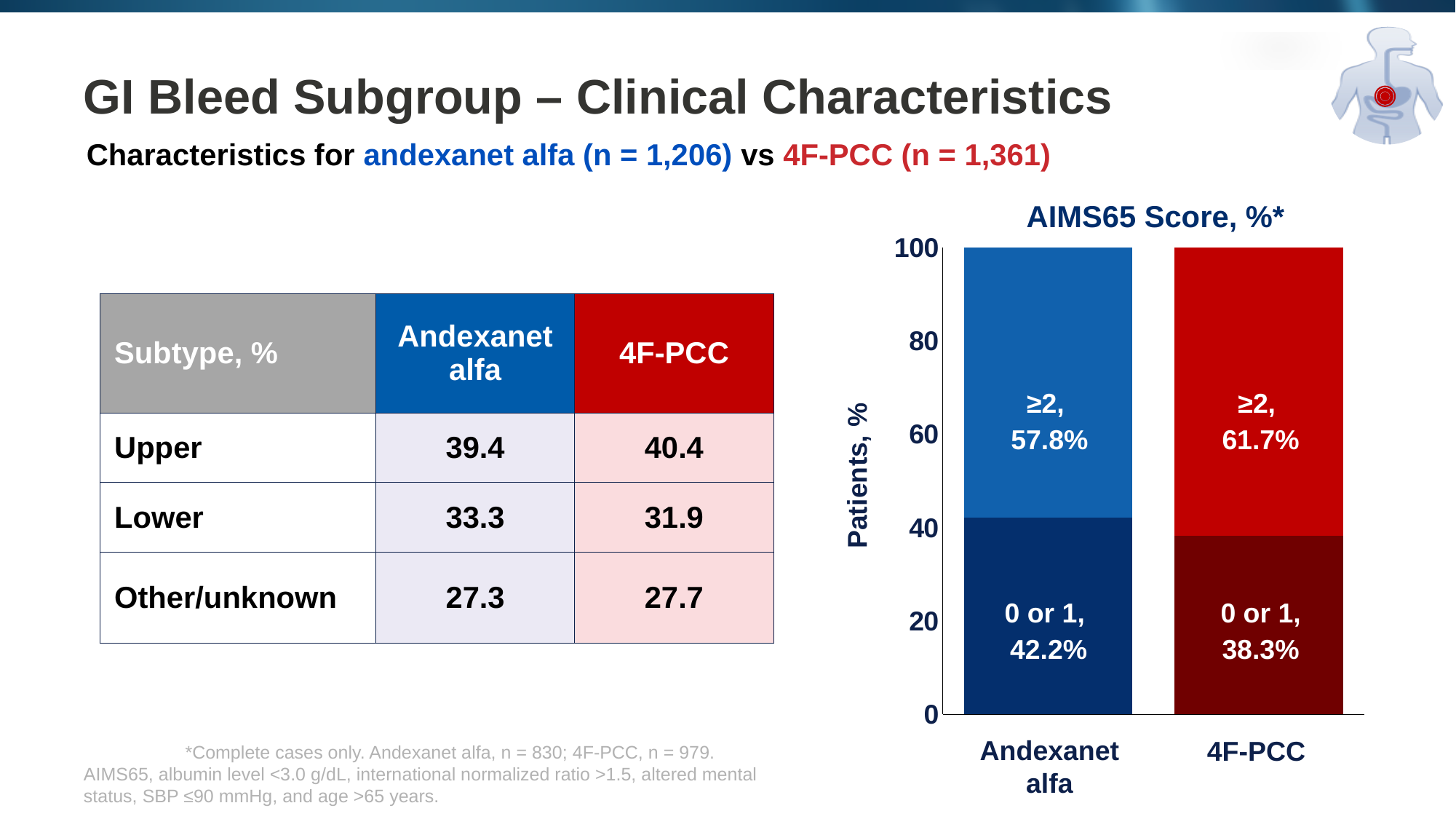
How many bars are shown in the AIMS65 Score chart? 2 In the AIMS65 Score chart, which group has the larger share of patients with a score of 0 or 1? Andexanet alfa What is the y-axis label of the AIMS65 Score chart? Patients, % In the AIMS65 Score chart, is the 0 or 1 share for 4F-PCC greater or less than 40? less In the AIMS65 Score chart, what percentage of andexanet alfa patients had a score of ≥2? 57.8% In the AIMS65 Score chart, what percentage of andexanet alfa patients had a score of 0 or 1? 42.2% What type of chart is the AIMS65 Score chart? Stacked bar chart In the AIMS65 Score chart, which group has the larger share of patients with a score of ≥2, andexanet alfa or 4F-PCC? 4F-PCC In the AIMS65 Score chart, what percentage of 4F-PCC patients had a score of 0 or 1? 38.3% In the AIMS65 Score chart, what percentage of 4F-PCC patients had a score of ≥2? 61.7% In the AIMS65 Score chart, what is the total of the stacked bar for andexanet alfa? 100% In the AIMS65 Score chart, what is the difference in percentage points between the ≥2 shares for 4F-PCC and andexanet alfa? 3.9